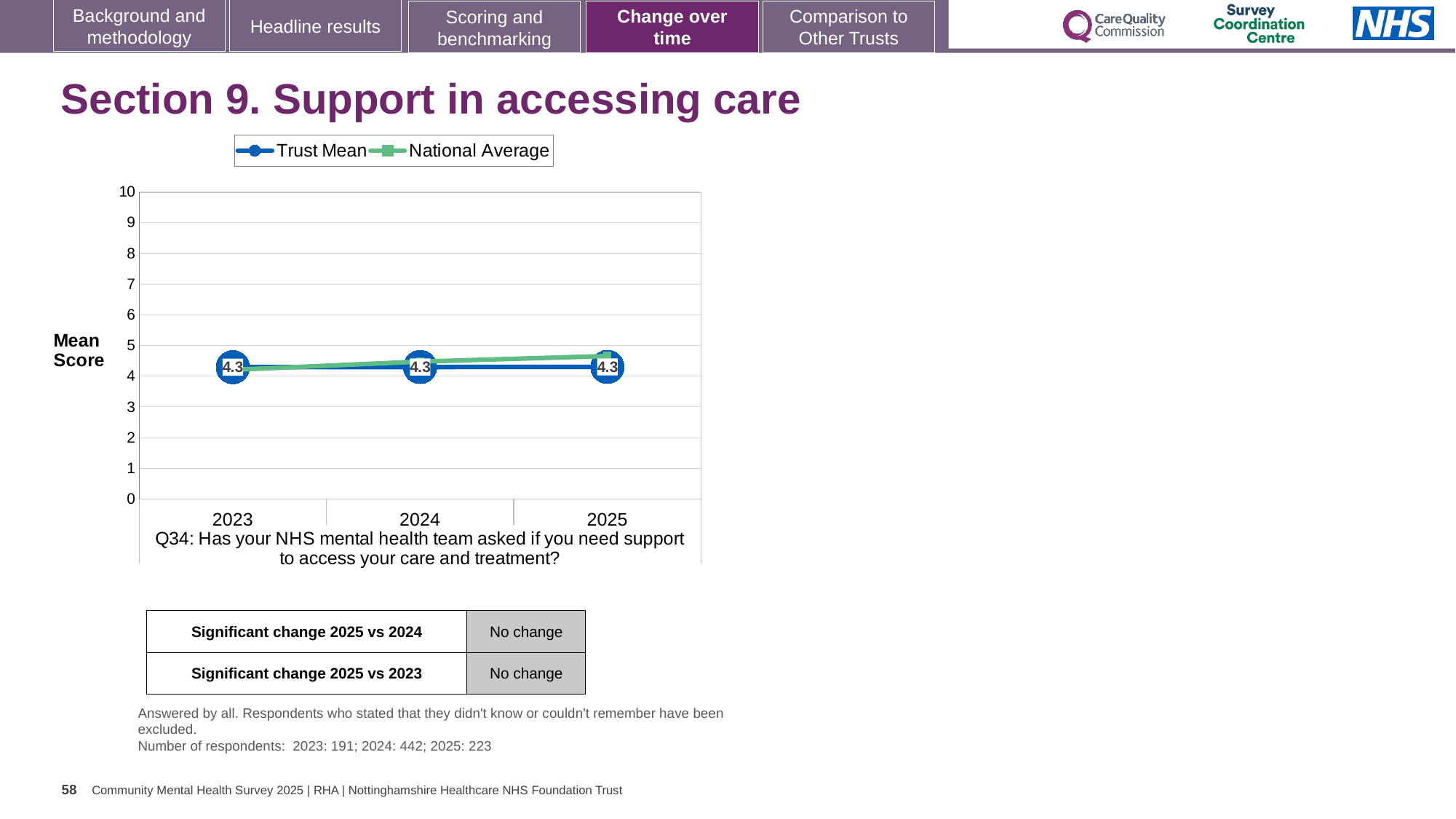
What is the Trust Mean score for 2024? 4.3 How many series does the legend list? 2 What is the Trust Mean score for 2025? 4.3 How many years are plotted along the x axis? 3 What are the two series named in the legend? Trust Mean and National Average What is the label on the y axis of the chart? Mean Score What is the Trust Mean score for 2023? 4.3 Does the Trust Mean rise, fall or stay flat from 2023 to 2025? Stays flat Is the National Average value for 2025 greater or less than 4? greater What kind of chart is shown on the slide? Line chart What is the difference between the Trust Mean score in 2025 and in 2023? 0.0 Is the National Average value for 2025 greater or less than 5? less